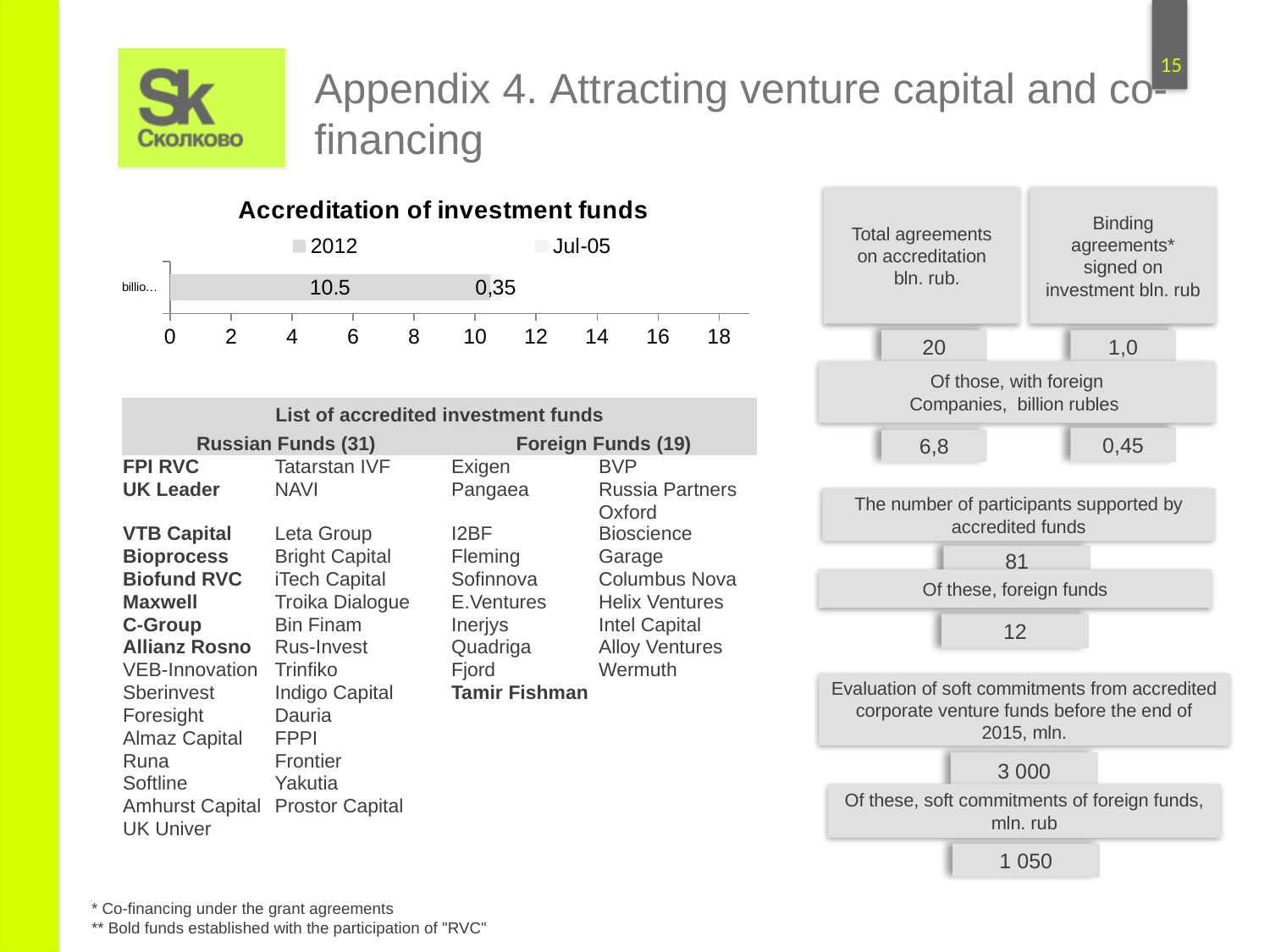
In the 'Accreditation of investment funds' chart, is the value for 2012 greater or less than 8? greater What kind of chart is shown under the title 'Accreditation of investment funds'? bar chart What is the title of the chart on the slide? Accreditation of investment funds How many bars (categories) are plotted in the 'Accreditation of investment funds' chart? 1 How many series does the legend of the 'Accreditation of investment funds' chart list? 2 In the 'Accreditation of investment funds' chart, which series has the larger value, 2012 or Jul-05? 2012 What is the value of the Jul-05 series in the 'Accreditation of investment funds' chart? 0,35 In the 'Accreditation of investment funds' chart, is the value for Jul-05 greater or less than 2? less What is the value of the 2012 series in the 'Accreditation of investment funds' chart? 10.5 What is the highest tick value shown on the x axis of the 'Accreditation of investment funds' chart? 18 What are the two legend entries of the 'Accreditation of investment funds' chart? 2012 and Jul-05